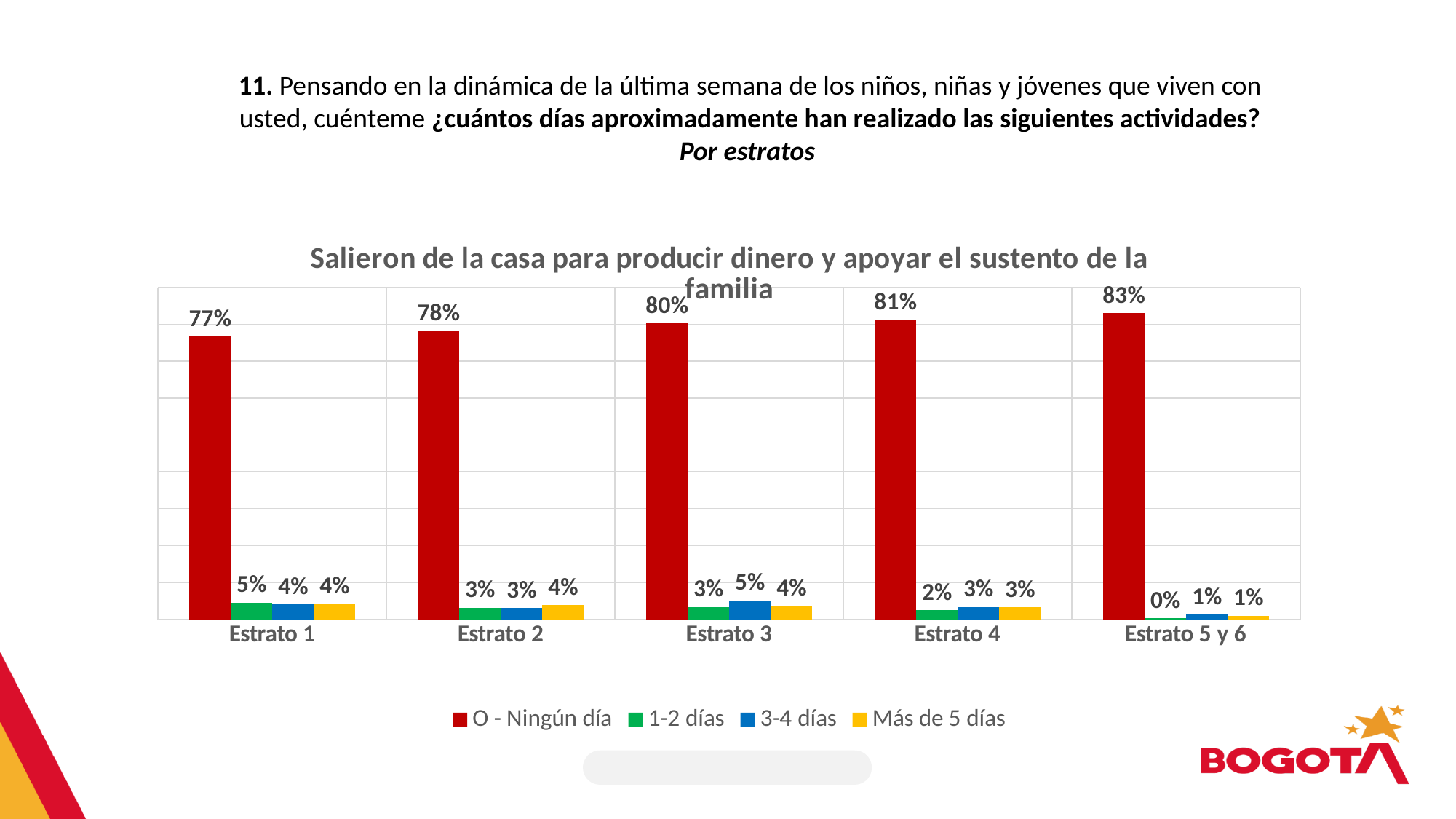
Which is larger: the '1-2 días' value for Estrato 1 or for Estrato 4? Estrato 1 Do the '0 - Ningún día' values rise or fall from Estrato 1 to Estrato 5 y 6? Rise How many estrato categories are shown on the x axis? 5 What is the difference between the '0 - Ningún día' values for Estrato 5 y 6 and Estrato 1? 6% What is the value for '1-2 días' in Estrato 5 y 6? 0% What is the value for '3-4 días' in Estrato 3? 5% What kind of chart is shown on the slide? Bar chart What is the value for '0 - Ningún día' in Estrato 1? 77% Which estrato has the lowest value for '0 - Ningún día'? Estrato 1 Which estrato has the highest value for '0 - Ningún día'? Estrato 5 y 6 How many series does the legend list? 4 What is the value for 'Más de 5 días' in Estrato 4? 3%